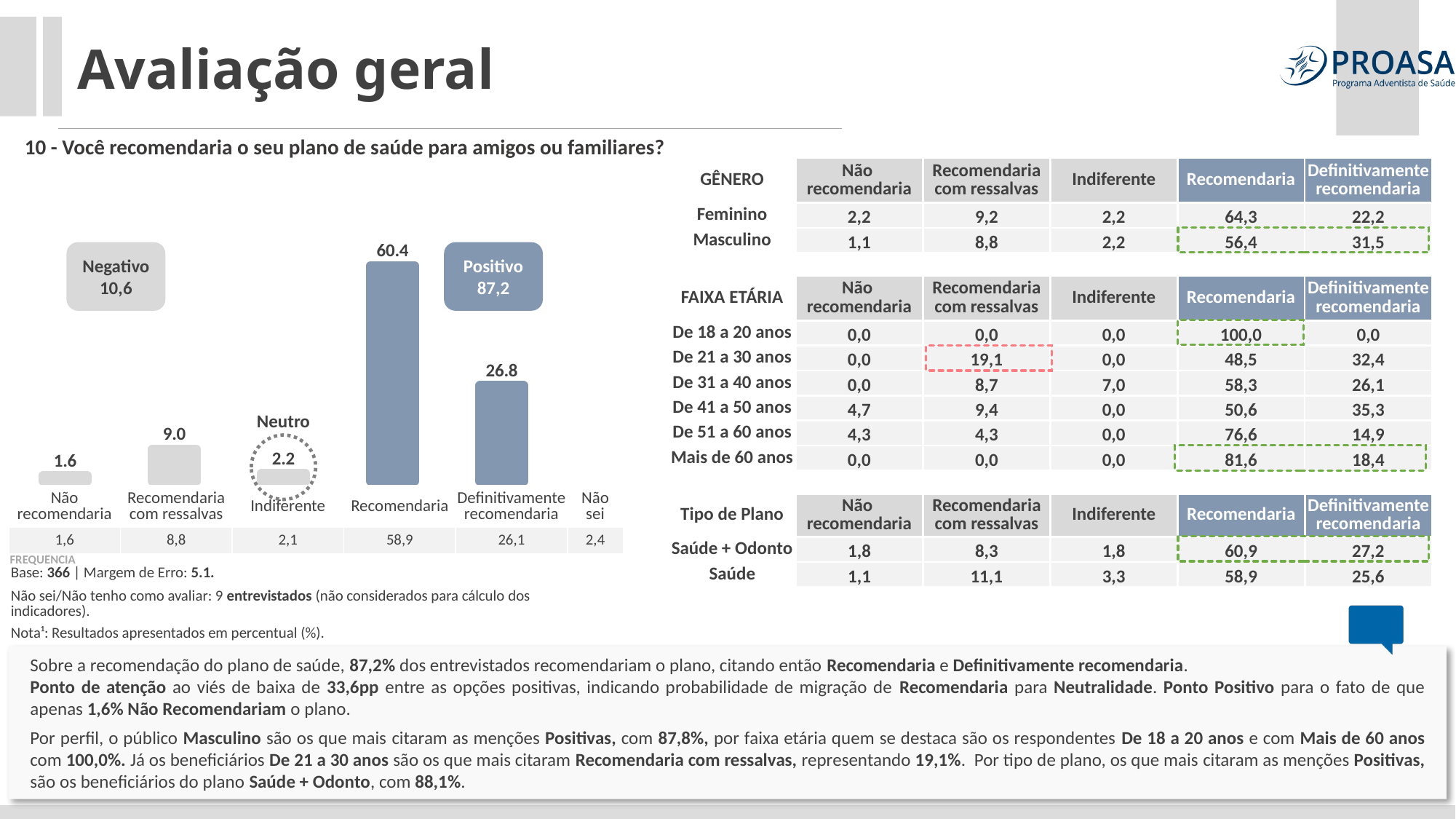
Which category has the lowest bar in the chart? Não recomendaria What is the difference between the values for Recomendaria and Definitivamente recomendaria in the bar chart? 33.6 Which category has the highest bar in the chart? Recomendaria In the bar chart, what is the value for Definitivamente recomendaria? 26.8 How many bars are plotted in the bar chart? 5 In the bar chart, what is the value for Recomendaria com ressalvas? 9.0 In the bar chart, what is the value for Indiferente? 2.2 In the bar chart, which is larger: Recomendaria com ressalvas or Indiferente? Recomendaria com ressalvas What value is shown in the 'Positivo' box above the bar chart? 87,2 What type of chart is shown on the left of the slide? bar chart In the bar chart, what is the value for Não recomendaria? 1.6 In the bar chart, what is the value for Recomendaria? 60.4